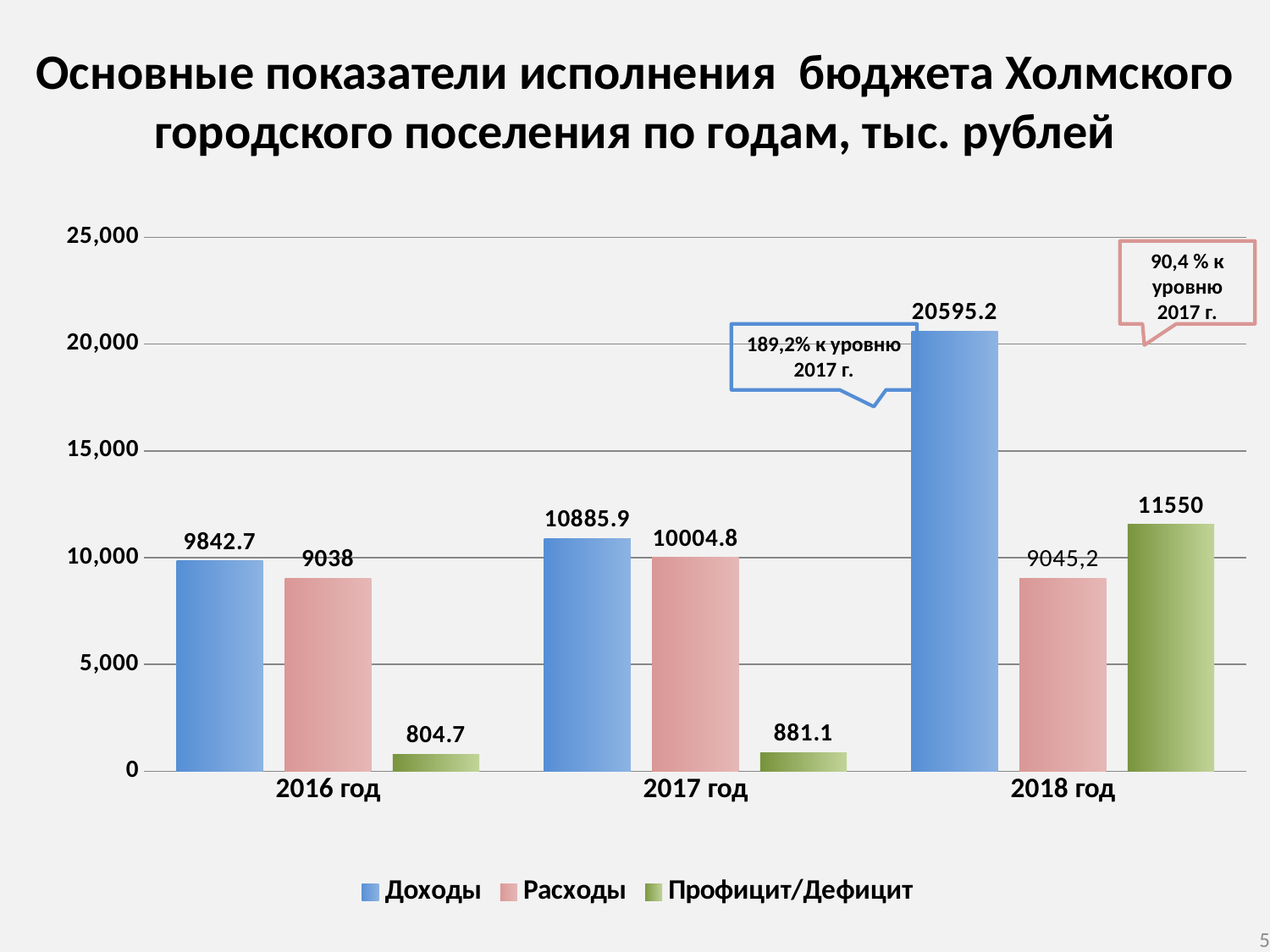
Is the value of Доходы for 2018 год greater or less than 20,000? greater Does Доходы rise or fall from 2016 год to 2018 год? rise What is the difference between Доходы and Расходы in 2017 год? 881.1 In which year is Доходы the highest? 2018 год What is the value of Расходы for 2018 год, as printed on the slide? 9045,2 Which is larger in 2018 год: Профицит/Дефицит or Расходы? Профицит/Дефицит What kind of chart is shown on the slide? bar chart What is the value of Профицит/Дефицит for 2016 год? 804.7 How many series does the legend list? 3 What is the value of Расходы for 2017 год? 10004.8 In which year is Профицит/Дефицит the lowest? 2016 год What is the value of Доходы for 2018 год? 20595.2